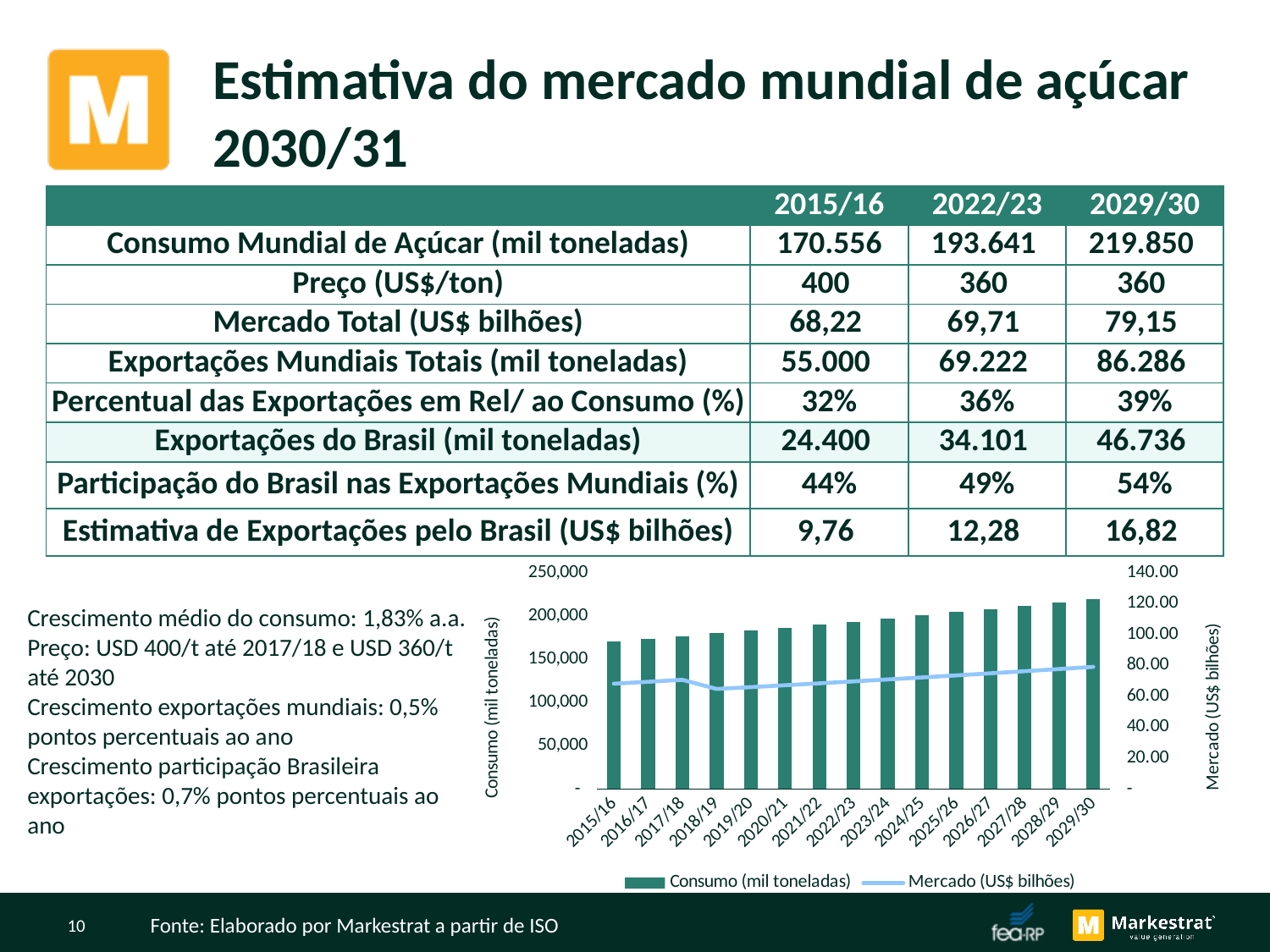
Do the Consumo (mil toneladas) bars rise or fall from 2015/16 to 2029/30? Rise Which series in the chart is drawn as a line? Mercado (US$ bilhões) How many series does the chart legend list? 2 Which season has the larger Consumo (mil toneladas) bar, 2015/16 or 2029/30? 2029/30 Is the Consumo (mil toneladas) bar for 2029/30 greater or less than 200,000? greater Which series in the chart is drawn as bars? Consumo (mil toneladas) Which season has the lowest Consumo (mil toneladas) bar in the chart? 2015/16 How many seasons (categories) are shown on the x axis of the chart? 15 Is the Mercado (US$ bilhões) line value for 2015/16 greater or less than 80.00? less Is the Consumo (mil toneladas) bar for 2015/16 greater or less than 200,000? less What kind of chart is shown at the bottom of the slide? A combined bar and line chart Which season has the highest Consumo (mil toneladas) bar in the chart? 2029/30